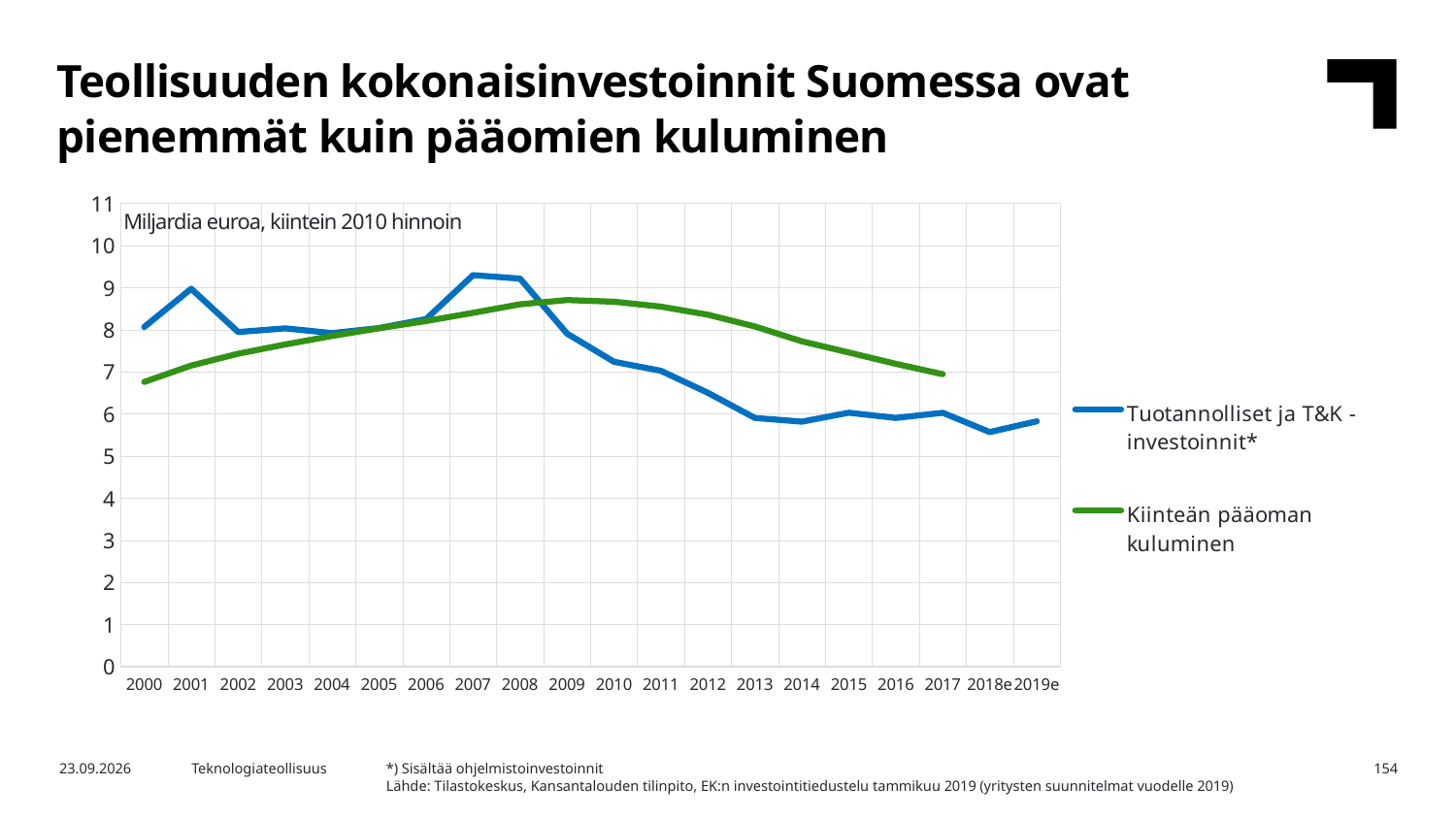
Does the Tuotannolliset ja T&K -investoinnit* line rise or fall from 2007 to 2013? fall Is the value for Kiinteän pääoman kuluminen in 2000 greater or less than 7? less How many years are shown on the x axis? 20 Is the value for Tuotannolliset ja T&K -investoinnit* in 2018e greater or less than 6? less What unit is stated in the label inside the chart area? Miljardia euroa, kiintein 2010 hinnoin Does the Kiinteän pääoman kuluminen line rise or fall from 2000 to 2008? rise Is the value for Tuotannolliset ja T&K -investoinnit* in 2007 greater or less than 9? greater How many series does the legend list? 2 In 2001, which series has the higher value: Tuotannolliset ja T&K -investoinnit* or Kiinteän pääoman kuluminen? Tuotannolliset ja T&K -investoinnit* In 2012, which series has the higher value: Tuotannolliset ja T&K -investoinnit* or Kiinteän pääoman kuluminen? Kiinteän pääoman kuluminen What kind of chart is shown on the slide? line chart